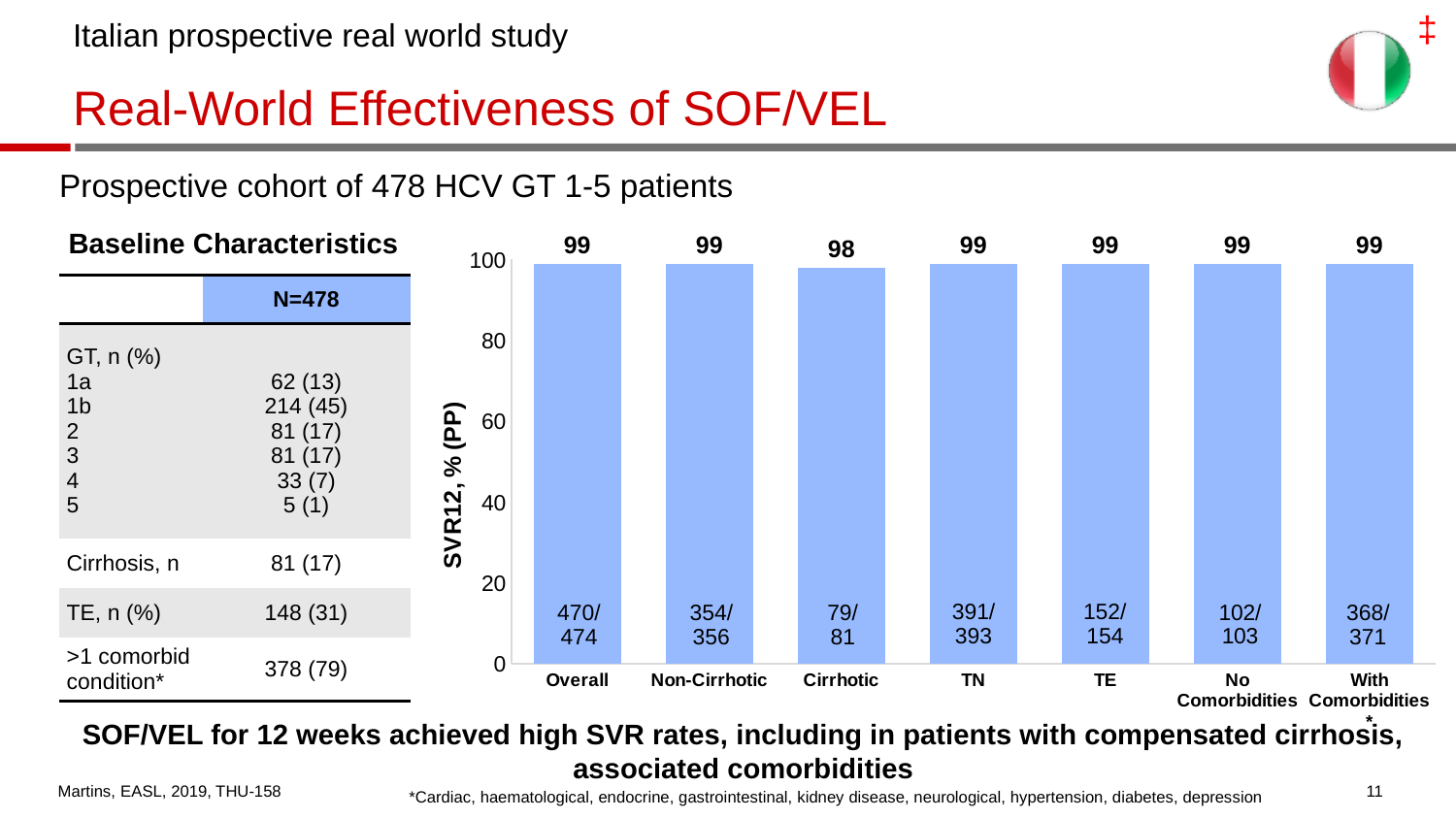
What is the SVR12 rate for the With Comorbidities group? 99 What kind of chart is used to show the SVR12 rates? Bar chart What is the SVR12 rate for the Overall group? 99 Is the SVR12 rate for the TE group greater or less than 80? greater Which has a higher SVR12 rate, TN or Cirrhotic? TN What fraction of patients is printed inside the Overall bar? 470/474 What is the SVR12 rate for the Cirrhotic group? 98 What is the label of the y axis of the chart? SVR12, % (PP) How many patient groups are shown on the x axis of the chart? 7 Which group has the lowest SVR12 rate? Cirrhotic What is the difference in SVR12 rate between the Non-Cirrhotic and Cirrhotic groups? 1 What fraction of patients is printed inside the Cirrhotic bar? 79/81